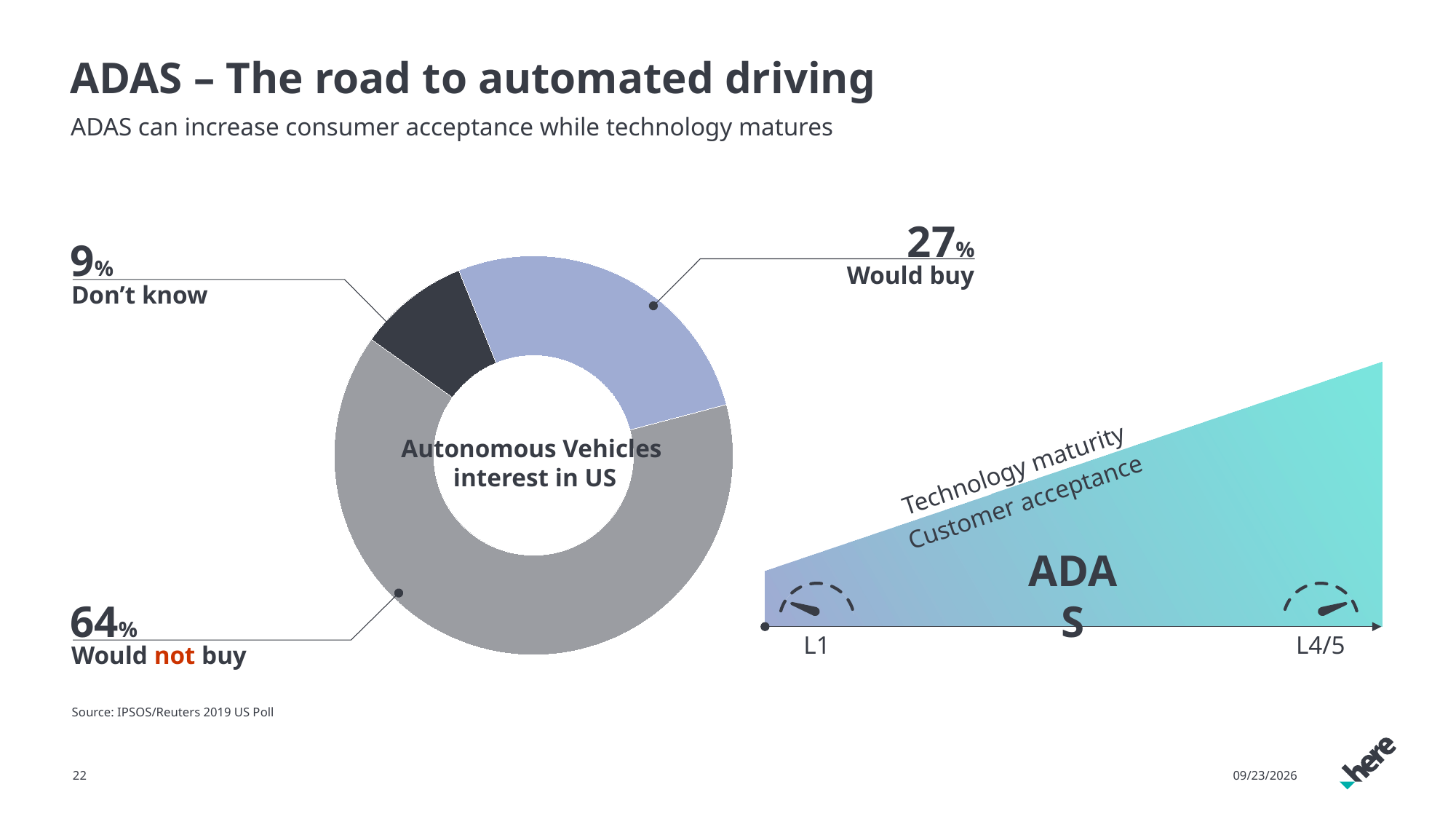
What is the title shown in the centre of the donut chart? Autonomous Vehicles interest in US What kind of chart is the 'Autonomous Vehicles interest in US' chart? Pie chart (donut) What percentage of respondents in the 'Autonomous Vehicles interest in US' chart would buy? 27% In the 'Autonomous Vehicles interest in US' chart, which is larger: 'Would buy' or 'Don't know'? Would buy In the 'Autonomous Vehicles interest in US' chart, what is the difference in percentage points between 'Would not buy' and 'Would buy'? 37 What is the source cited for the 'Autonomous Vehicles interest in US' chart? IPSOS/Reuters 2019 US Poll In the 'Autonomous Vehicles interest in US' chart, what is the combined share of 'Would buy' and 'Don't know'? 36% How many categories are shown in the 'Autonomous Vehicles interest in US' chart? 3 What percentage of respondents in the 'Autonomous Vehicles interest in US' chart would not buy? 64% What percentage of respondents in the 'Autonomous Vehicles interest in US' chart answered 'Don't know'? 9% Which category has the smallest share in the 'Autonomous Vehicles interest in US' chart? Don't know Which category has the largest share in the 'Autonomous Vehicles interest in US' chart? Would not buy